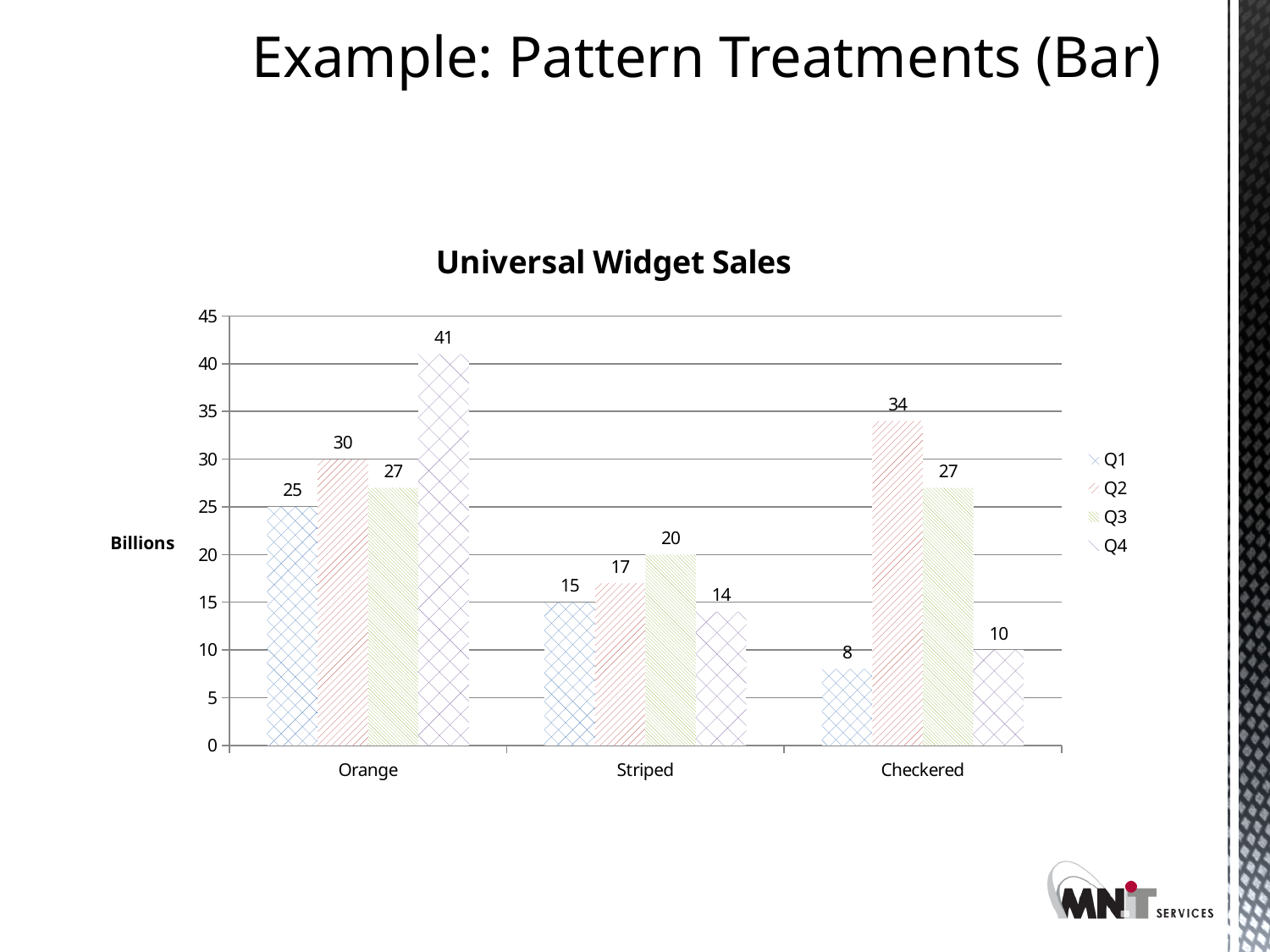
Which category has the highest Q2 value? Checkered What is the Q3 value for Striped? 20 How many categories are shown on the x axis? 3 What is the Q4 value for Orange? 41 What is the title of the chart? Universal Widget Sales Which is larger for Striped: the Q2 value or the Q4 value? Q2 Which category has the lowest Q1 value? Checkered What is the difference between the Q4 values for Orange and Checkered? 31 How many series does the legend list? 4 What is the label on the vertical axis? Billions What kind of chart is shown? bar chart What is the Q1 value for Checkered? 8